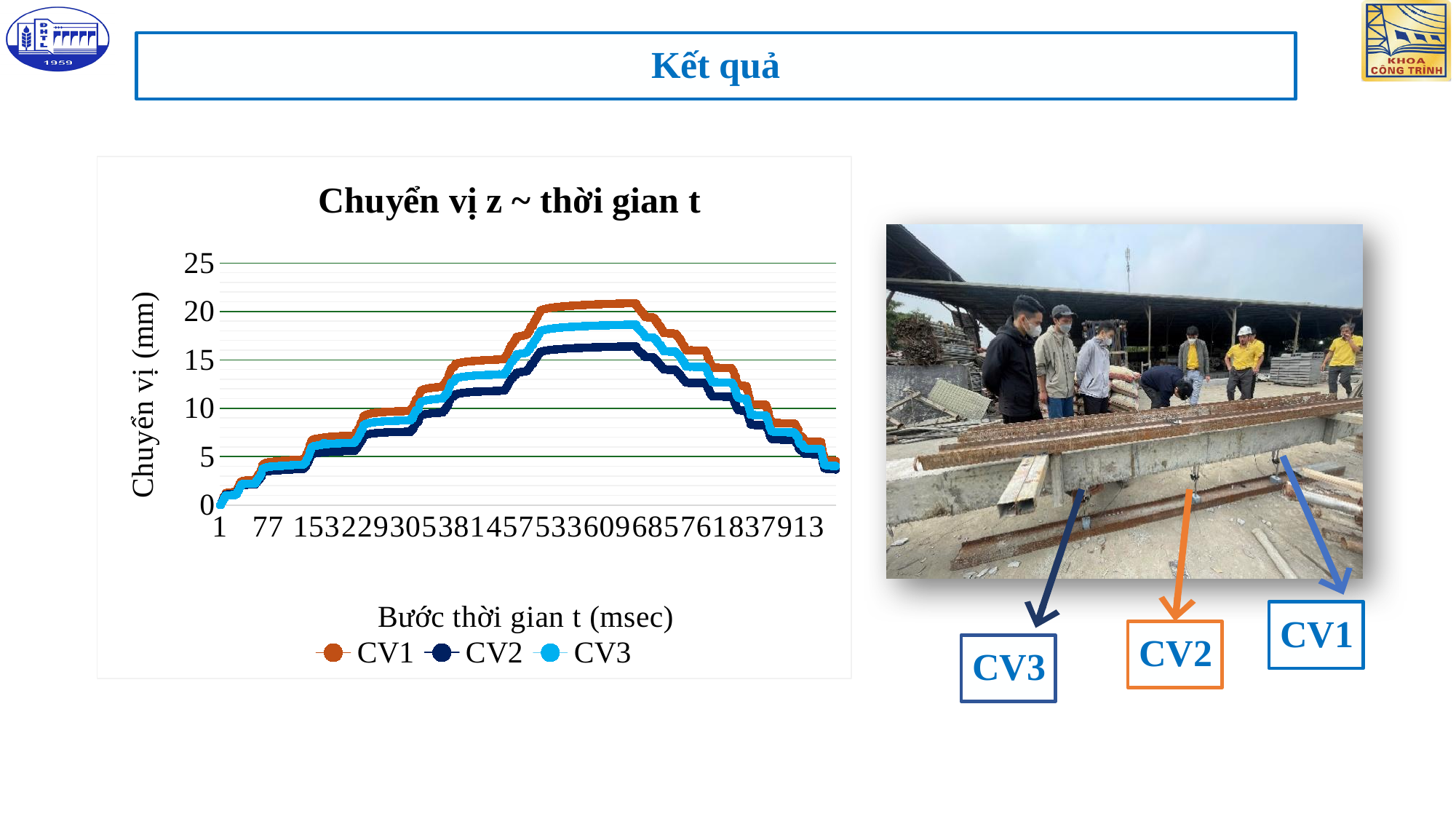
Which series reaches the highest peak value in the chart? CV1 At the peak of the chart, which series is larger, CV1 or CV3? CV1 What is the title of the chart? Chuyển vị z ~ thời gian t How many series does the legend of the chart list? 3 Is the peak value of CV3 greater or less than 15? greater What kind of chart is shown on the slide? line chart Is the peak value of CV2 greater or less than 20? less Do the values of CV2 rise or fall along the x axis from time step 685 to time step 913? fall What is the label of the vertical axis of the chart? Chuyển vị (mm) Do the values of CV1 rise or fall along the x axis from time step 1 to time step 609? rise Is the peak value of CV1 greater or less than 20? greater Which series has the lowest peak value in the chart? CV2